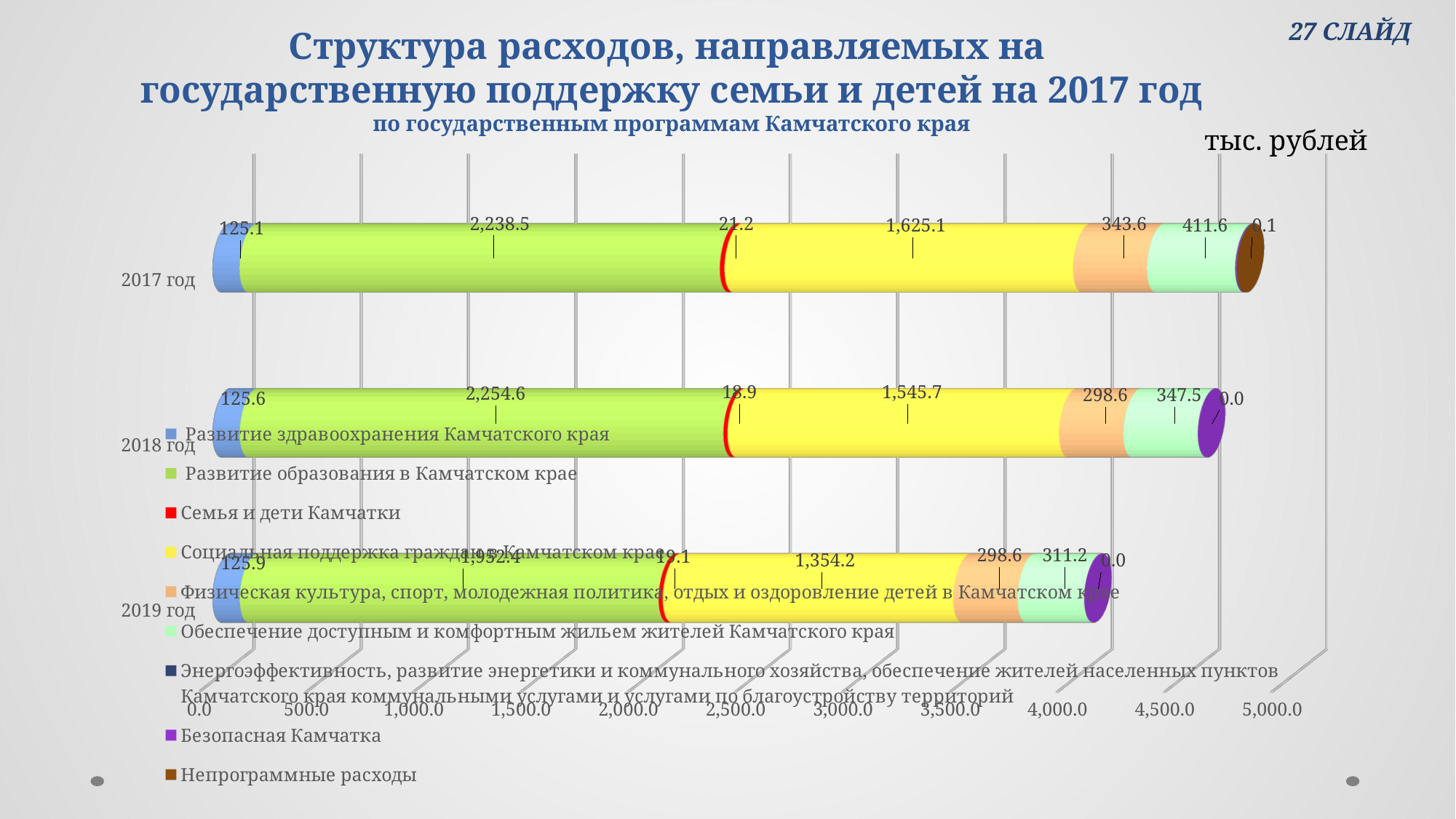
In what units are the values on the chart expressed? тыс. рублей What kind of chart is shown on the slide? Stacked bar chart By how much does Социальная поддержка граждан в Камчатском крае in 2017 год exceed the value in 2018 год? 79.4 Which year has the larger value for Развитие образования в Камчатском крае, 2017 год or 2018 год? 2018 год What is the value for Социальная поддержка граждан в Камчатском крае in 2019 год? 1,354.2 In which year is the value for Обеспечение доступным и комфортным жильем жителей Камчатского края the highest? 2017 год How many years (categories) are plotted on the chart? 3 What is the value for Физическая культура, спорт, молодежная политика, отдых и оздоровление детей in 2018 год? 298.6 What is the value for Развитие здравоохранения Камчатского края in 2017 год? 125.1 How many series does the legend list? 9 What is the value for Развитие образования в Камчатском крае in 2017 год? 2,238.5 What is the value for Социальная поддержка граждан в Камчатском крае in 2018 год? 1,545.7